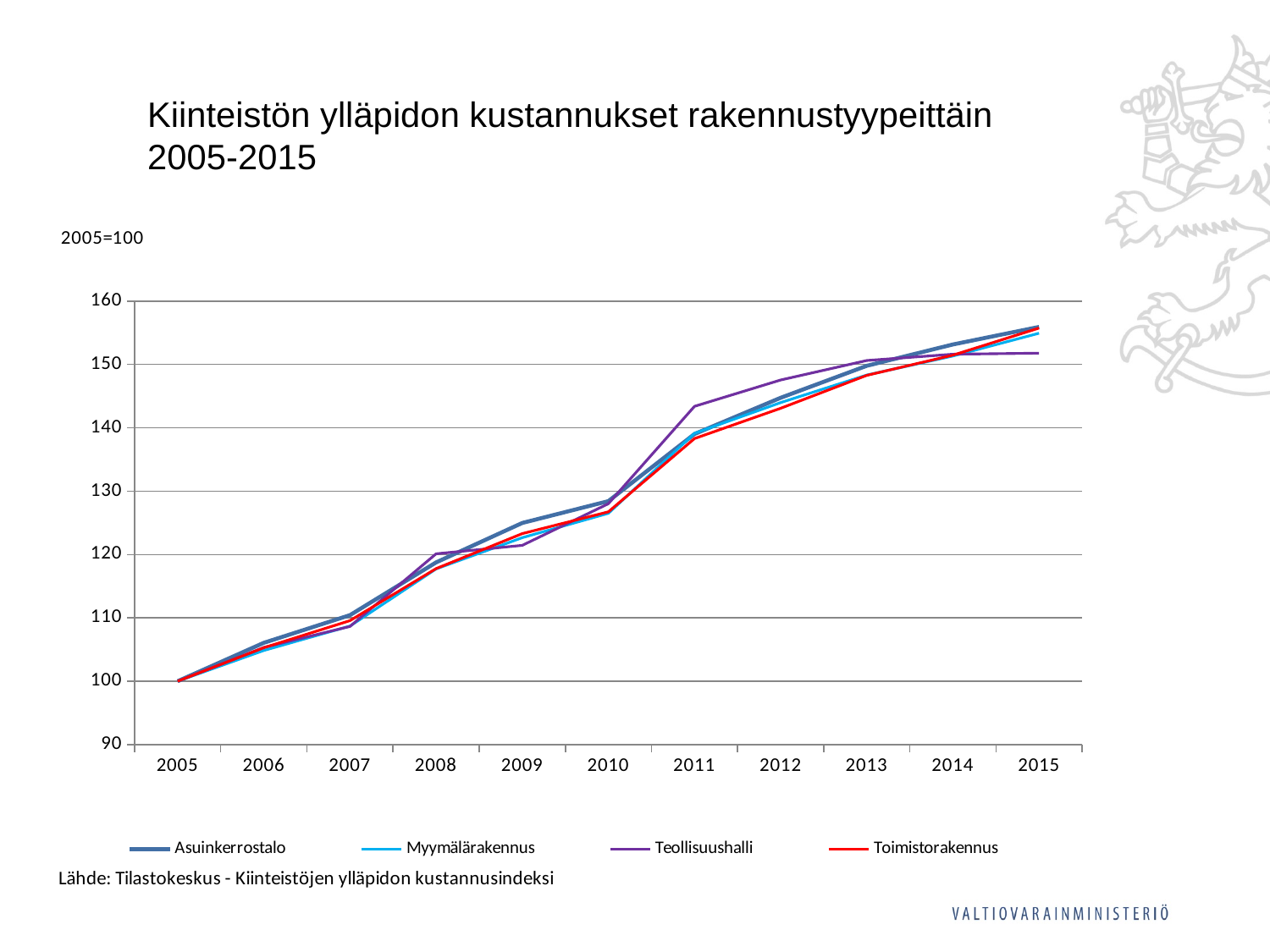
What kind of chart is shown on the slide? line chart How many series does the legend list? 4 Is the value for Asuinkerrostalo in 2015 greater or less than 150? greater What is the title of the chart? Kiinteistön ylläpidon kustannukset rakennustyypeittäin 2005-2015 Is the value for Teollisuushalli in 2011 greater or less than 140? greater What is the value of Asuinkerrostalo in 2005? 100 How many years are plotted along the x axis? 11 In 2011, which is larger: the value for Teollisuushalli or the value for Toimistorakennus? Teollisuushalli Which series has the highest value in 2011? Teollisuushalli Is the value for Toimistorakennus in 2010 greater or less than 130? less Which series has the lowest value in 2015? Teollisuushalli Do the values for Toimistorakennus rise or fall from 2005 to 2015? rise